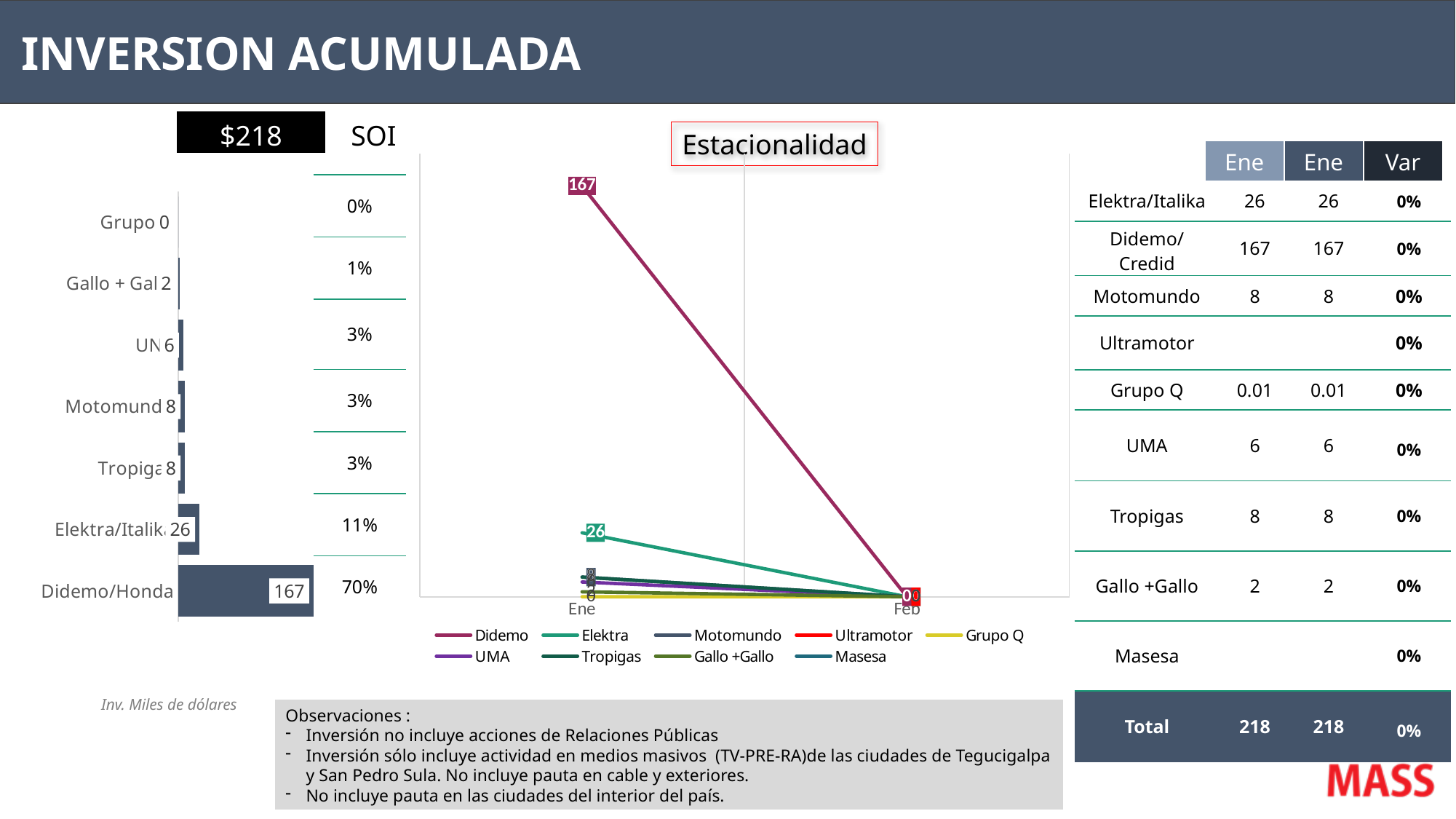
In the bar chart on the left, what is the value for Didemo/Honda? 167 In the bar chart on the left, which category has the highest value? Didemo/Honda In the bar chart on the left, which category has the lowest value? Grupo What type of chart is the 'Estacionalidad' chart? line chart In the 'Estacionalidad' chart, how many series does the legend list? 9 In the bar chart on the left, which is larger, the value for Elektra/Italika or the value for Motomundo? Elektra/Italika In the 'Estacionalidad' chart, what is the value for Didemo in Ene? 167 In the bar chart on the left, what is the value for Elektra/Italika? 26 In the 'Estacionalidad' chart, does the Didemo line rise or fall from Ene to Feb? fall In the bar chart on the left, how many categories are shown? 7 In the bar chart on the left, what is the difference between the values for Didemo/Honda and Elektra/Italika? 141 What type of chart is the chart on the left side of the slide? bar chart